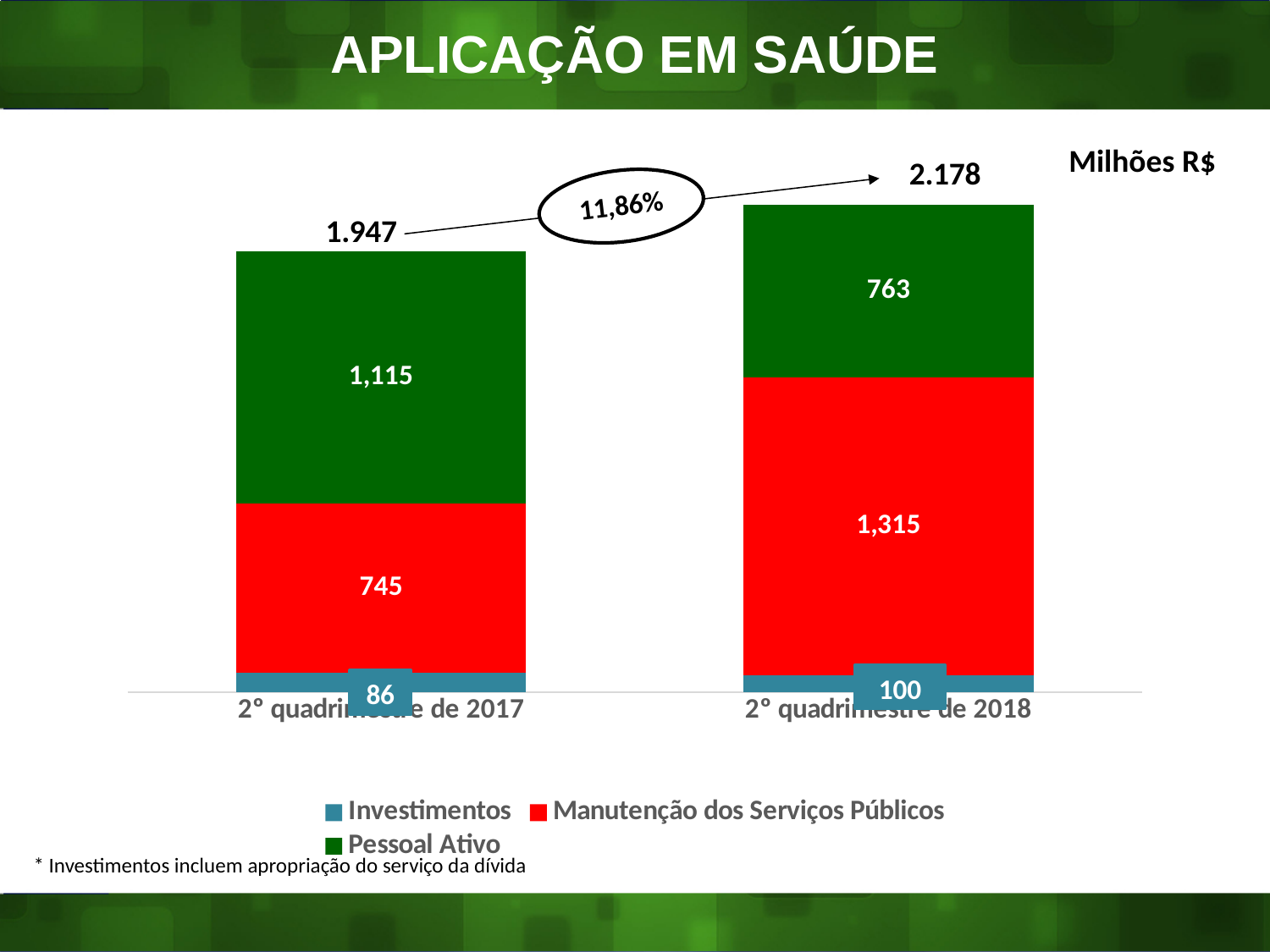
What is the difference between Investimentos in 2018 and Investimentos in 2017? 14 What percentage change is shown in the oval between the two bars? 11,86% What type of chart is shown on the slide? Stacked bar chart What is the total shown above the bar for the 2º quadrimestre de 2017? 1.947 How many series does the legend list? 3 Which is larger: Pessoal Ativo in 2017 or Pessoal Ativo in 2018? Pessoal Ativo in 2017 What is the value for Investimentos in the 2º quadrimestre de 2017? 86 How many categories are shown on the x axis? 2 What is the value for Pessoal Ativo in the 2º quadrimestre de 2017? 1,115 What is the total shown above the bar for the 2º quadrimestre de 2018? 2.178 What unit is indicated at the top right of the chart? Milhões R$ What is the value for Manutenção dos Serviços Públicos in the 2º quadrimestre de 2018? 1,315